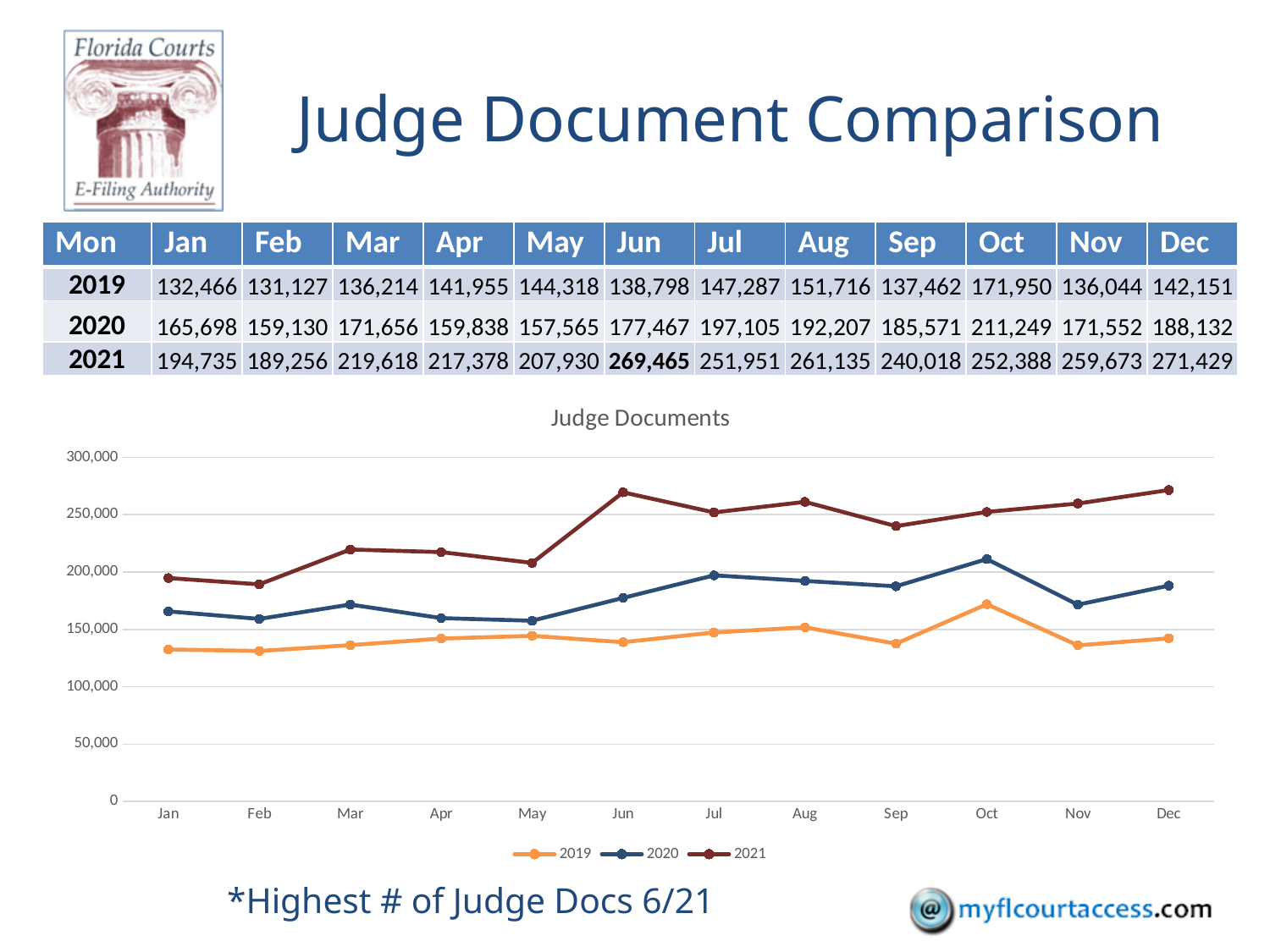
How many series does the legend list? 3 Does the 2021 series rise or fall from May to June? rise What is the difference between the 2021 and 2020 values in June? 91,998 What type of chart is shown on the slide? line chart Is the value for 2021 in December greater or less than 250,000? greater What is the value for 2021 in June? 269,465 Which month has the highest value for the 2019 series? Oct What is the value for 2020 in October? 211,249 How many months are plotted along the x axis? 12 Which is larger, the 2020 value in July or the 2020 value in August? July What is the chart title? Judge Documents Which month has the lowest value for the 2021 series? Feb